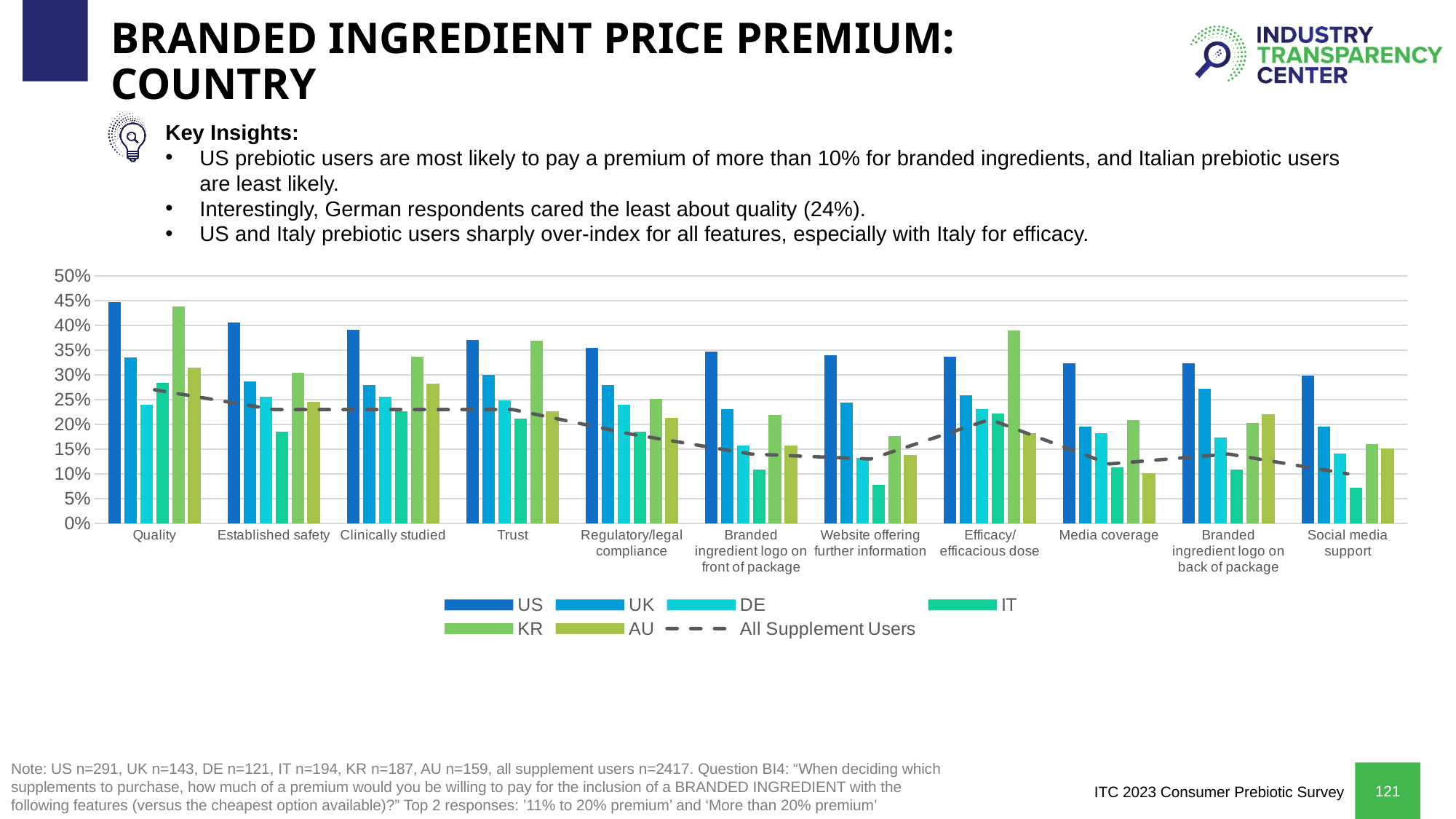
How many series does the chart's legend list? 7 How many categories are shown along the x axis of the chart? 11 Is the value for UK in the Website offering further information category greater or less than 30%? less Does the dashed All Supplement Users line generally rise or fall from left to right across the categories? fall In which category is the US bar the highest? Quality Is the value for KR in the Efficacy/efficacious dose category greater or less than 35%? greater What kind of chart is shown on the slide? combination bar and line chart Is the value for AU in the Media coverage category greater or less than 15%? less In the Trust category, which is larger, the KR value or the DE value? KR Which series in the legend is shown as a dashed line rather than bars? All Supplement Users